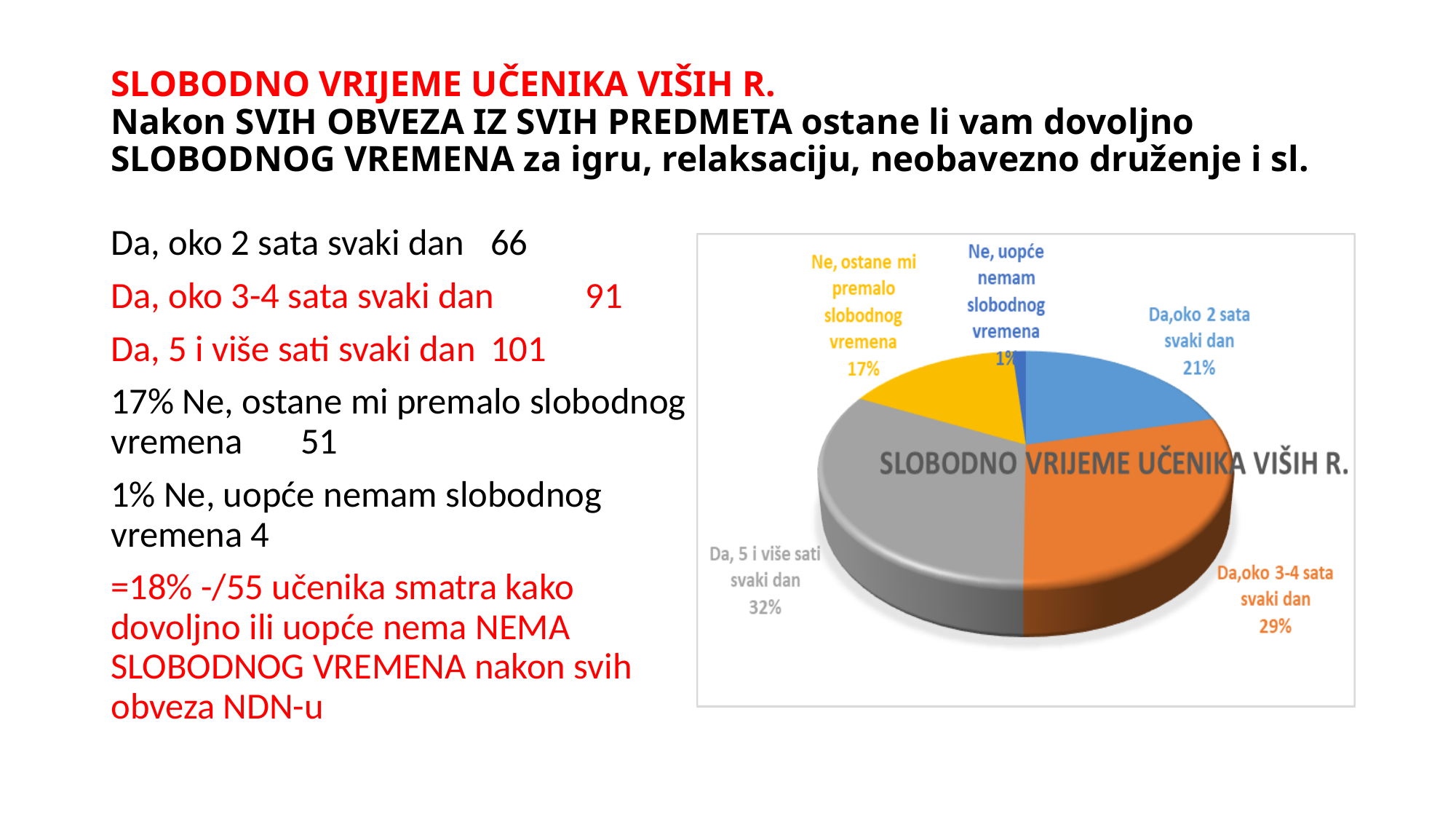
How many slices does the pie chart have? 5 What percentage does the chart show for "Ne, ostane mi premalo slobodnog vremena"? 17% Which category has the smallest share of the pie? Ne, uopće nemam slobodnog vremena What percentage does the chart show for "Da,oko 3-4 sata svaki dan"? 29% Which is larger: the share for "Da,oko 3-4 sata svaki dan" or the share for "Ne, ostane mi premalo slobodnog vremena"? Da,oko 3-4 sata svaki dan What percentage does the chart show for "Da, 5 i više sati svaki dan"? 32% What is the title of the chart? SLOBODNO VRIJEME UČENIKA VIŠIH R. What percentage does the chart show for "Ne, uopće nemam slobodnog vremena"? 1% What percentage does the chart show for "Da,oko 2 sata svaki dan"? 21% Which category has the largest share of the pie? Da, 5 i više sati svaki dan What is the difference in percentage points between "Da, 5 i više sati svaki dan" and "Da,oko 2 sata svaki dan"? 11 What kind of chart is shown on the slide? pie chart